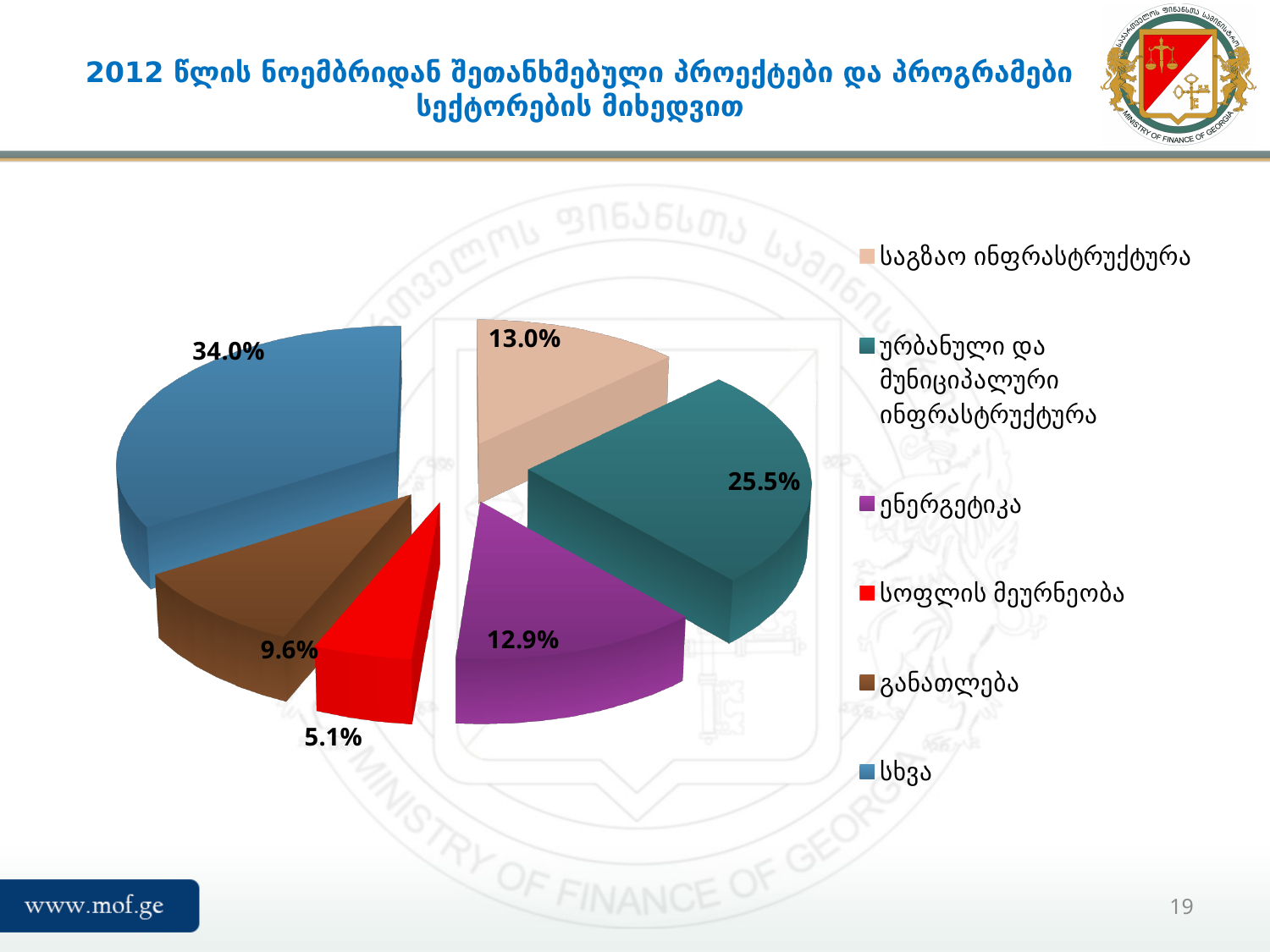
What share of the pie does the ენერგეტიკა slice have? 12.9% How many slices does the pie chart have? 6 What is the difference in percentage points between the სხვა slice and the ურბანული და მუნიციპალური ინფრასტრუქტურა slice? 8.5 Which sector has the largest share of the pie? სხვა What share of the pie does the სხვა slice have? 34.0% Which is larger, the share for განათლება or the share for სოფლის მეურნეობა? განათლება Which sector has the smallest share of the pie? სოფლის მეურნეობა What share of the pie does the საგზაო ინფრასტრუქტურა slice have? 13.0% What share of the pie does the სოფლის მეურნეობა slice have? 5.1% What kind of chart is shown on the slide? pie chart What share of the pie does the განათლება slice have? 9.6% What share of the pie does the ურბანული და მუნიციპალური ინფრასტრუქტურა slice have? 25.5%